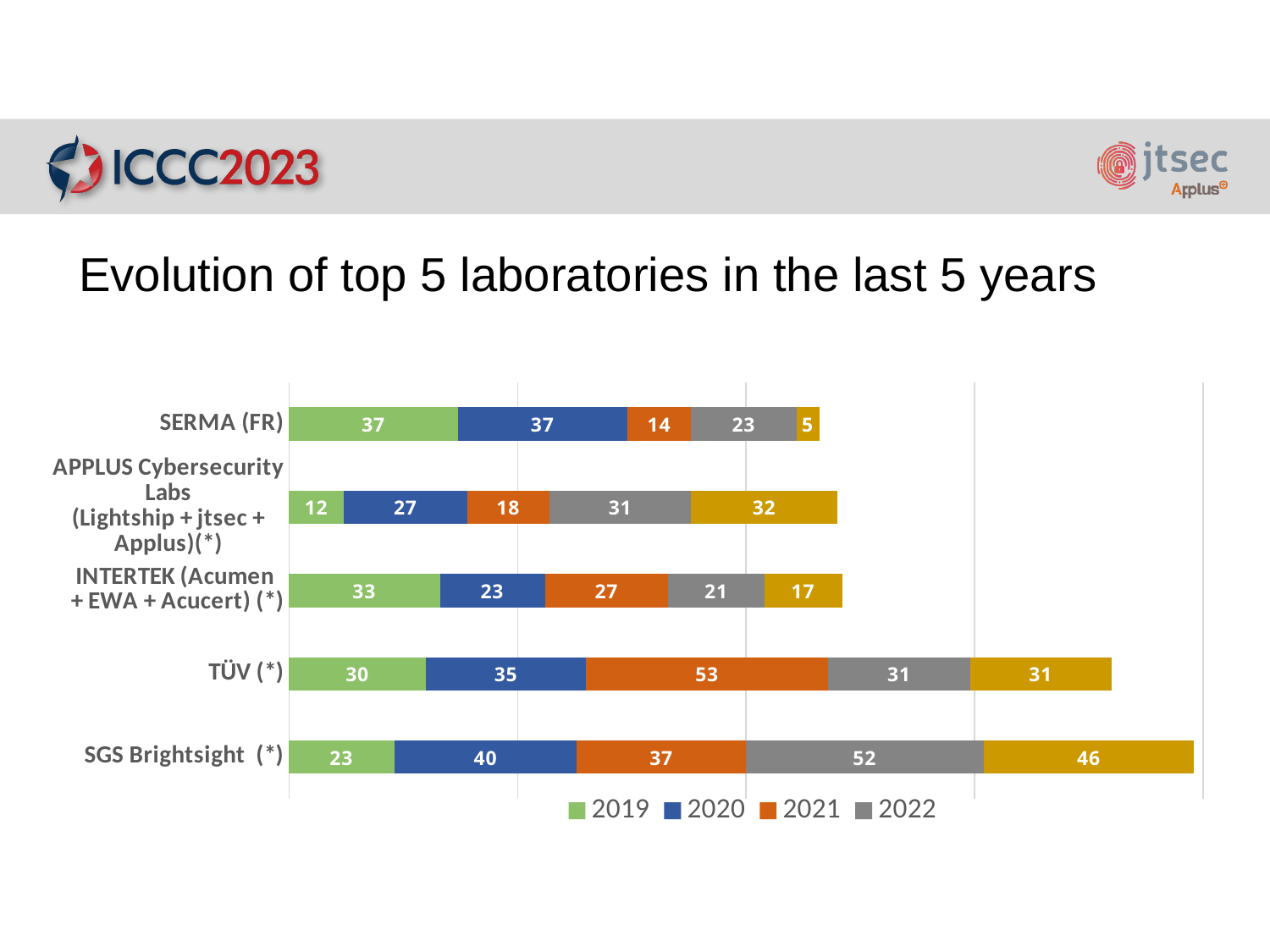
Which laboratory has the lowest 2019 value? APPLUS Cybersecurity Labs (Lightship + jtsec + Applus)(*) What is the 2021 value for TÜV (*)? 53 How many laboratories are shown on the chart? 5 How many series does the chart legend list? 4 What kind of chart is shown on the slide? Stacked bar chart What is the total of all segments in the SERMA (FR) bar? 116 What is the 2022 value for SGS Brightsight (*)? 52 Which is larger, the 2020 value for TÜV (*) or the 2020 value for SGS Brightsight (*)? SGS Brightsight (*) What is the 2019 value for SERMA (FR)? 37 Which laboratory has the highest 2021 value? TÜV (*) What is the title of the slide above the chart? Evolution of top 5 laboratories in the last 5 years What is the difference between the 2022 value for SGS Brightsight (*) and the 2022 value for SERMA (FR)? 29